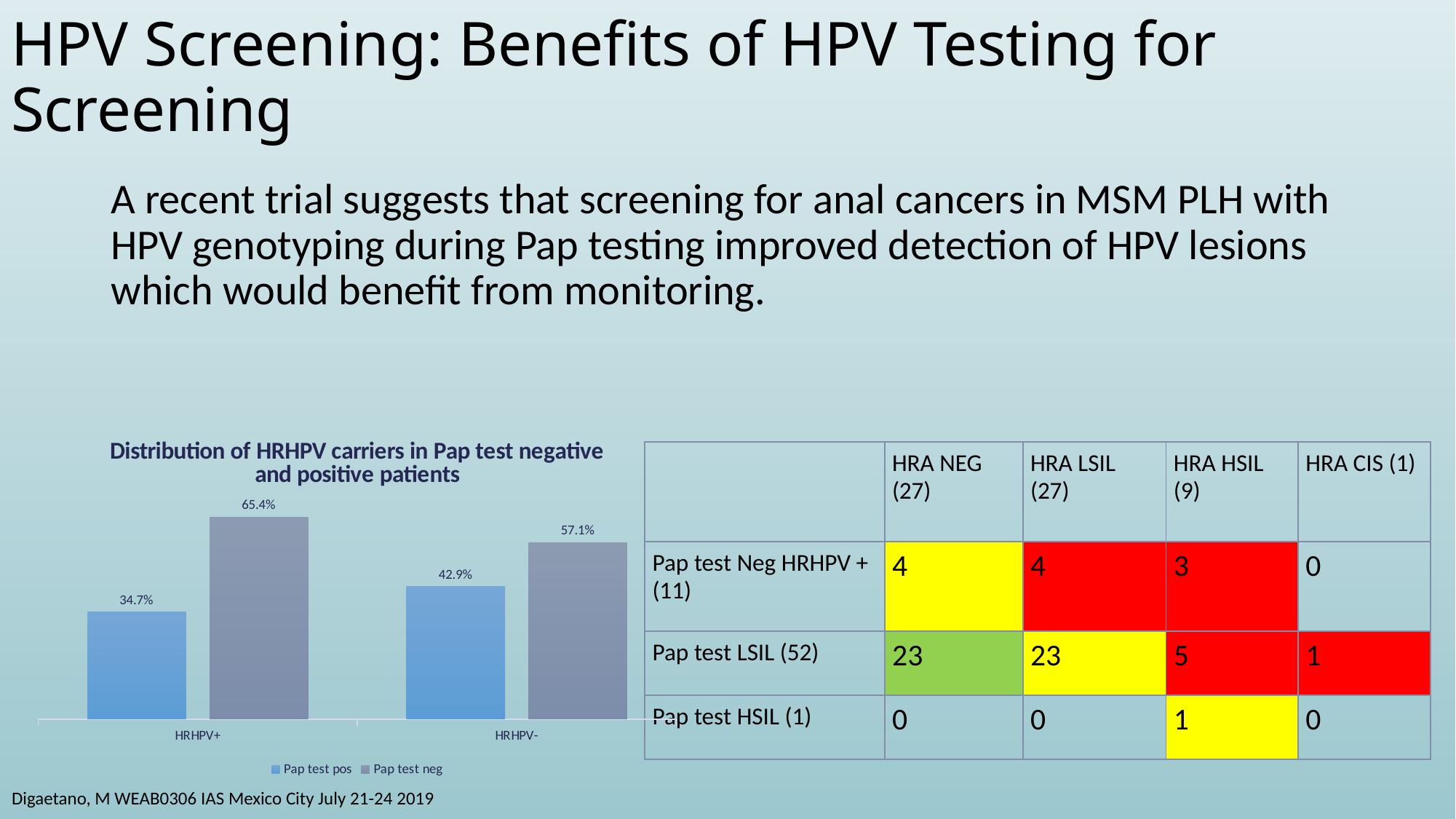
What is the difference between Pap test neg and Pap test pos in the HRHPV+ category? 30.7% How many series does the chart legend list? 2 What is the value for Pap test neg in the HRHPV+ category? 65.4% Which is larger: Pap test pos for HRHPV+ or Pap test pos for HRHPV-? Pap test pos for HRHPV- What is the difference between Pap test neg and Pap test pos in the HRHPV- category? 14.2% What is the value for Pap test pos in the HRHPV- category? 42.9% Which bar has the lowest value in the chart? Pap test pos, HRHPV+ What is the value for Pap test pos in the HRHPV+ category? 34.7% How many categories are shown on the x axis of the chart? 2 Which bar has the highest value in the chart? Pap test neg, HRHPV+ What type of chart is shown on the slide? Bar chart What is the value for Pap test neg in the HRHPV- category? 57.1%